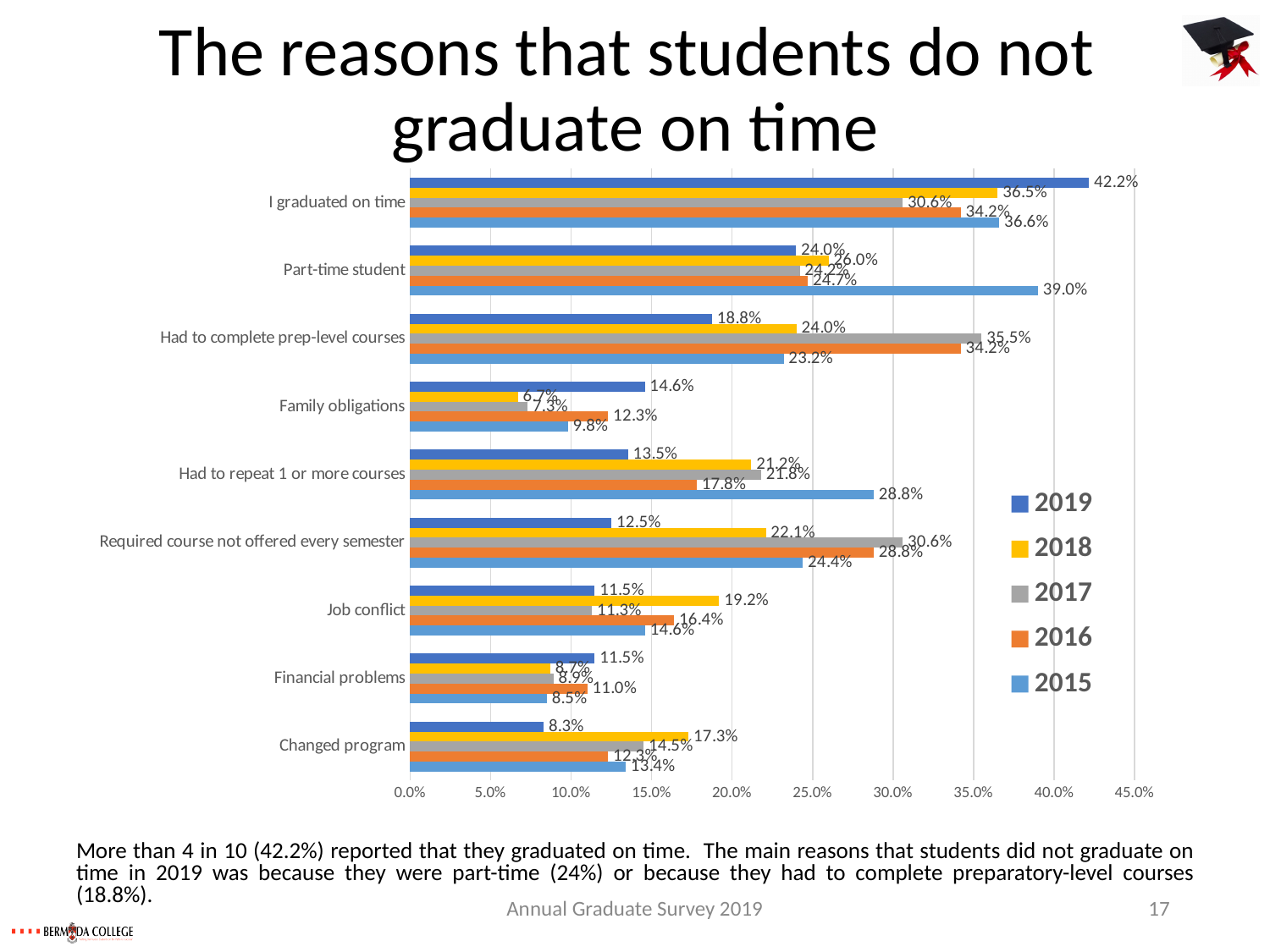
How many series does the legend list? 5 What is the 2019 value for 'I graduated on time'? 42.2% How many reason categories are plotted on the chart? 9 Which category has the lowest 2019 value? Changed program What is the 2015 value for 'Part-time student'? 39.0% What kind of chart is shown on the slide? bar chart What is the difference between the 2019 and 2018 values for 'I graduated on time'? 5.7% Which year is shown in yellow in the legend? 2018 For 'Family obligations', which is larger: the 2019 value or the 2016 value? 2019 Which category has the highest 2019 value? I graduated on time What is the 2018 value for 'Job conflict'? 19.2% What is the 2019 value for 'Had to complete prep-level courses'? 18.8%